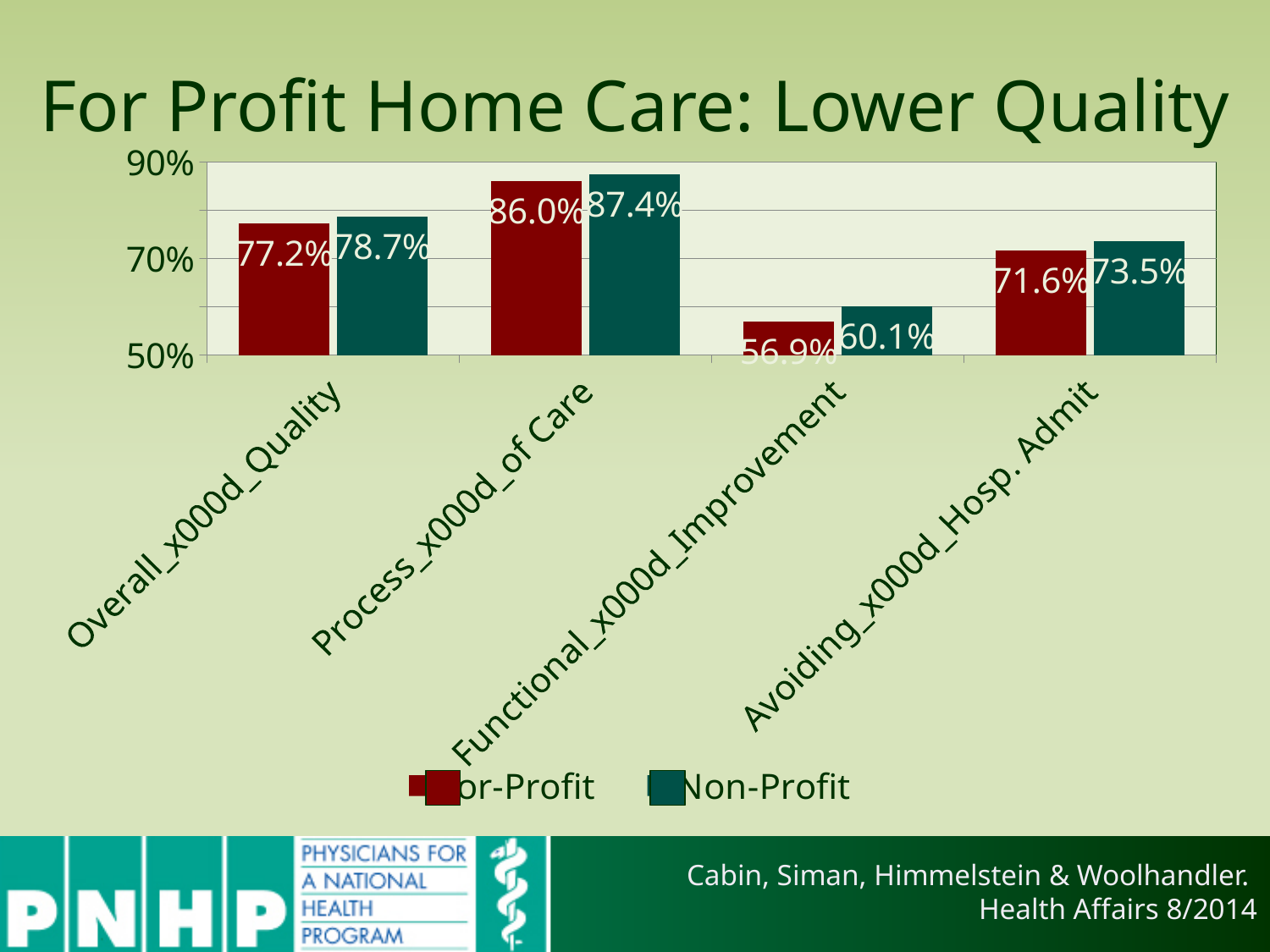
How many series does the legend list? 2 What is the For-Profit value for Overall Quality? 77.2% What kind of chart is shown on the slide? Bar chart What is the For-Profit value for Functional Improvement? 56.9% What is the Non-Profit value for Process of Care? 87.4% For Overall Quality, which is larger: the For-Profit value or the Non-Profit value? Non-Profit Which category has the highest Non-Profit value? Process of Care Which category has the lowest For-Profit value? Functional Improvement What is the Non-Profit value for Avoiding Hosp. Admit? 73.5% How many categories are shown on the x axis? 4 What is the title of the slide? For Profit Home Care: Lower Quality For Functional Improvement, how much higher is the Non-Profit value than the For-Profit value? 3.2 percentage points